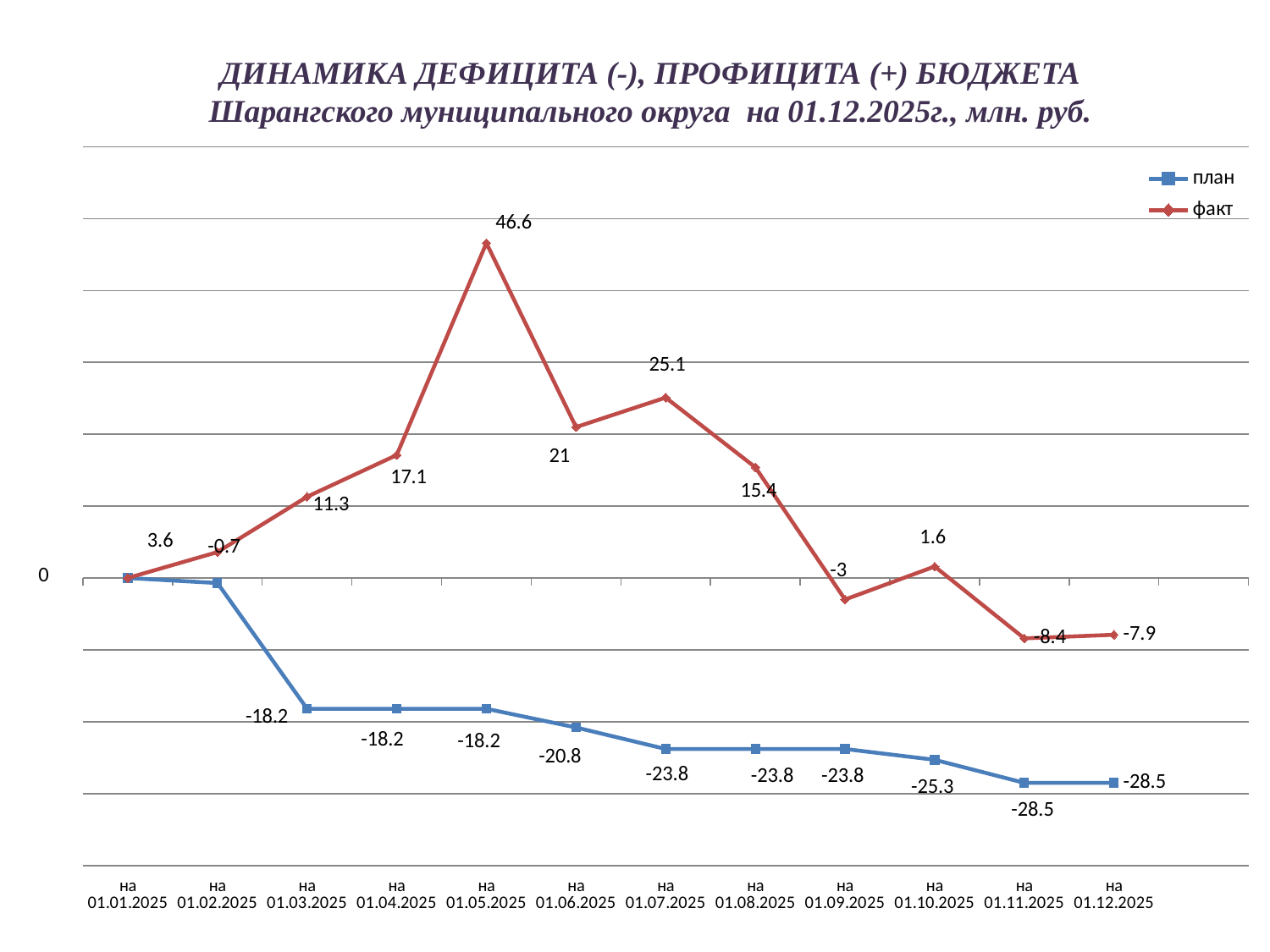
On 01.07.2025, which series has the larger value, план or факт? факт How many dates are plotted along the x axis? 12 What is the факт value on 01.10.2025? 1.6 What is the lowest value of the план series? -28.5 On which date does the факт series reach its highest value? на 01.05.2025 What are the two entries in the legend? план, факт What is the план value on 01.12.2025? -28.5 What is the факт value on 01.07.2025? 25.1 How many series does the legend list? 2 By how much does the факт value on 01.05.2025 exceed the факт value on 01.06.2025? 25.6 What kind of chart is shown on the slide? line chart Does the план series generally rise or fall from 01.01.2025 to 01.12.2025? fall